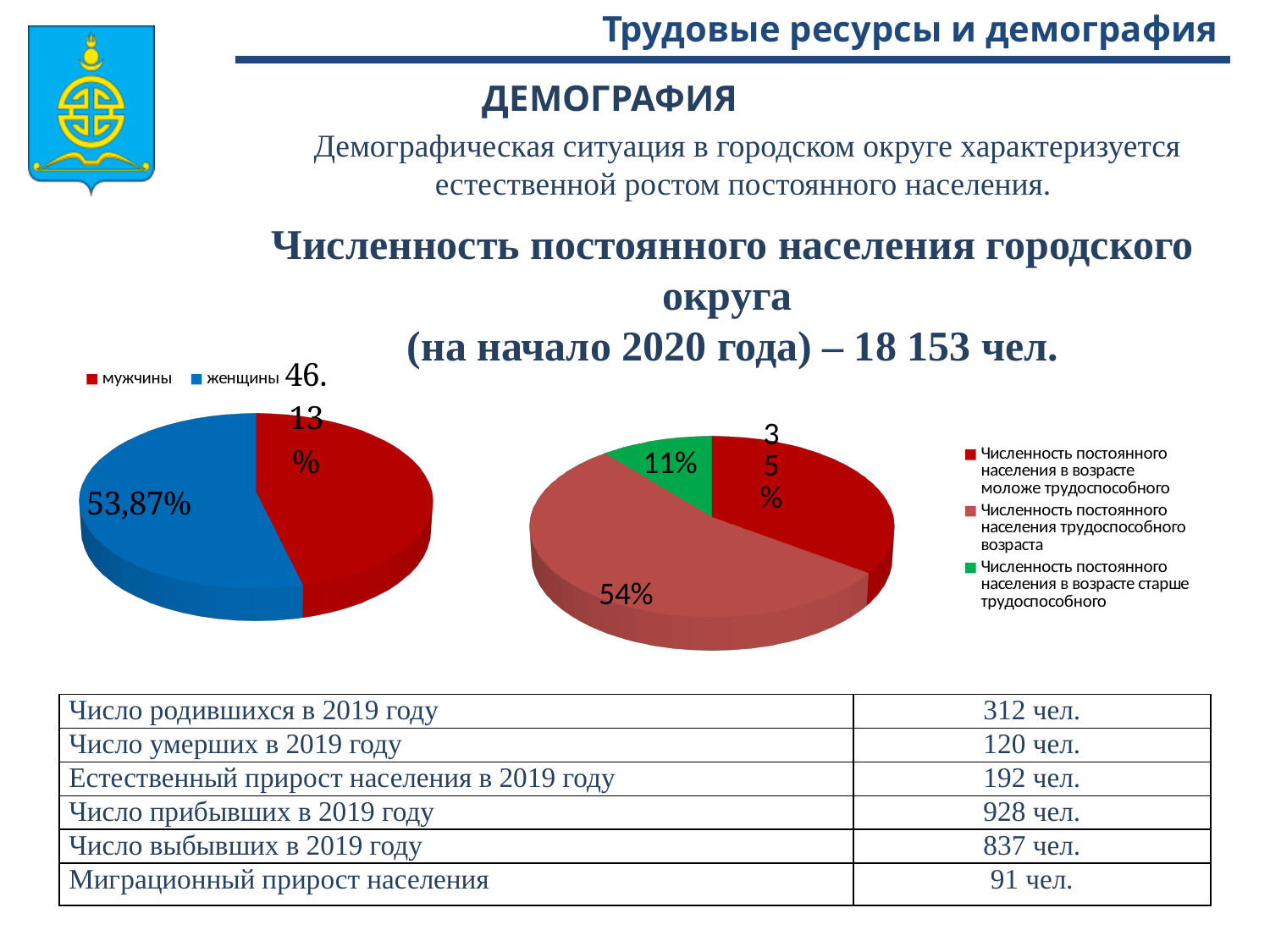
In the right pie chart, what share is shown for Численность постоянного населения трудоспособного возраста? 54% In the left pie chart, what share is shown for женщины? 53,87% What kind of chart is the left chart on the slide? pie chart In the right pie chart, what share is shown for Численность постоянного населения в возрасте старше трудоспособного? 11% In the right pie chart, which category has the smallest share? Численность постоянного населения в возрасте старше трудоспособного How many entries does the legend of the right pie chart list? 3 In the right pie chart, what is the difference between the share of трудоспособного возраста and the share of старше трудоспособного? 43% In the right pie chart, which category has the largest share? Численность постоянного населения трудоспособного возраста In the left pie chart, which slice is larger, мужчины or женщины? женщины In the left pie chart, what share is shown for мужчины? 46.13% In the right pie chart, what share is shown for Численность постоянного населения в возрасте моложе трудоспособного? 35% How many slices does the left pie chart have? 2